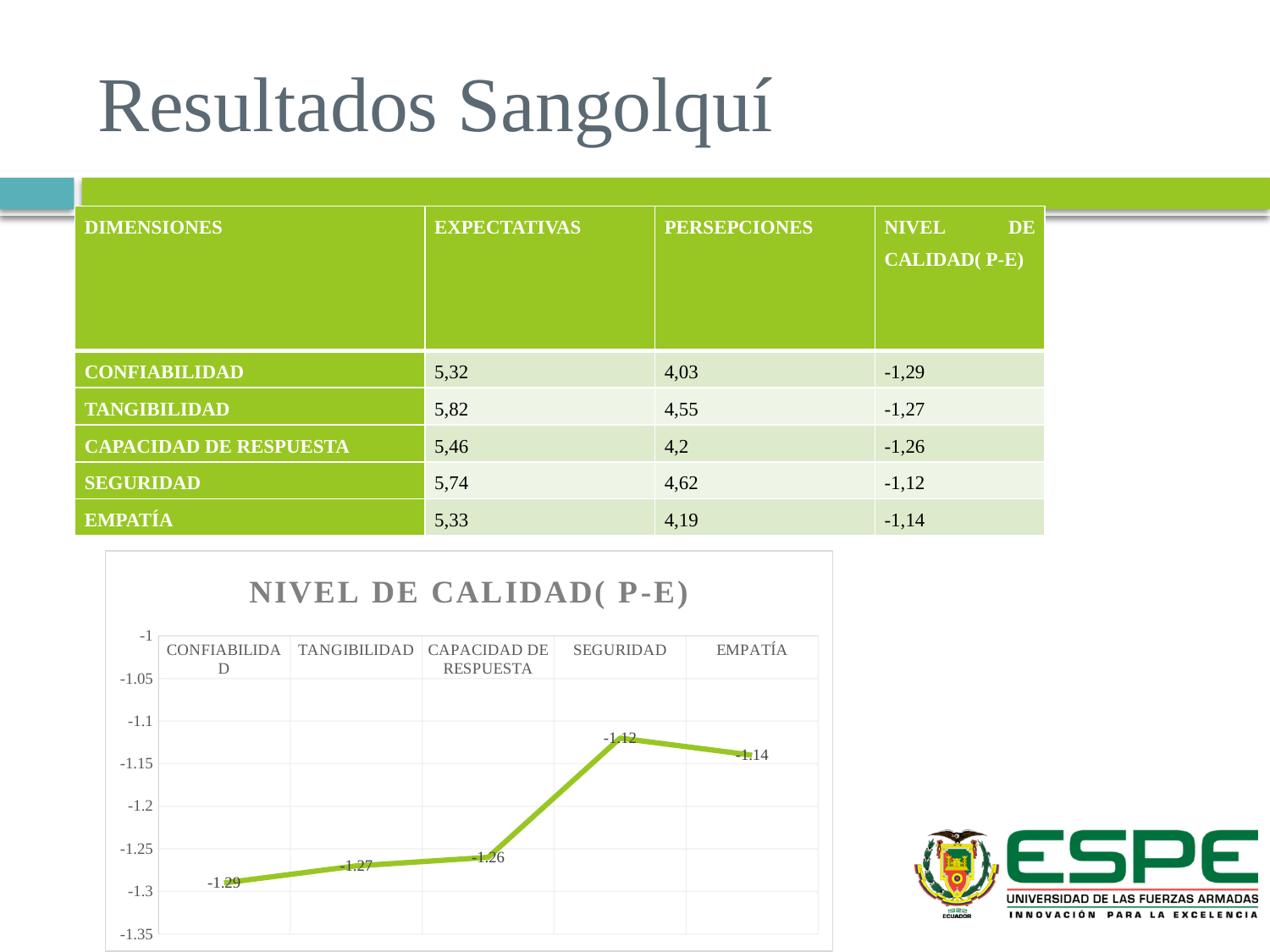
What is the difference between the values for SEGURIDAD and CONFIABILIDAD in the chart? 0.17 Which category has the highest value in the chart? SEGURIDAD Which category has the lowest value in the chart? CONFIABILIDAD What is the title of the chart? NIVEL DE CALIDAD( P-E) What is the value plotted for SEGURIDAD in the chart? -1.12 What is the value plotted for EMPATÍA in the chart? -1.14 What is the value plotted for CONFIABILIDAD in the chart? -1.29 How many categories are plotted in the chart? 5 Do the values rise or fall from CONFIABILIDAD to SEGURIDAD in the chart? rise What kind of chart is shown on the slide? line chart Which has the larger value in the chart, TANGIBILIDAD or CAPACIDAD DE RESPUESTA? CAPACIDAD DE RESPUESTA Is the value for TANGIBILIDAD in the chart greater or less than -1.2? less